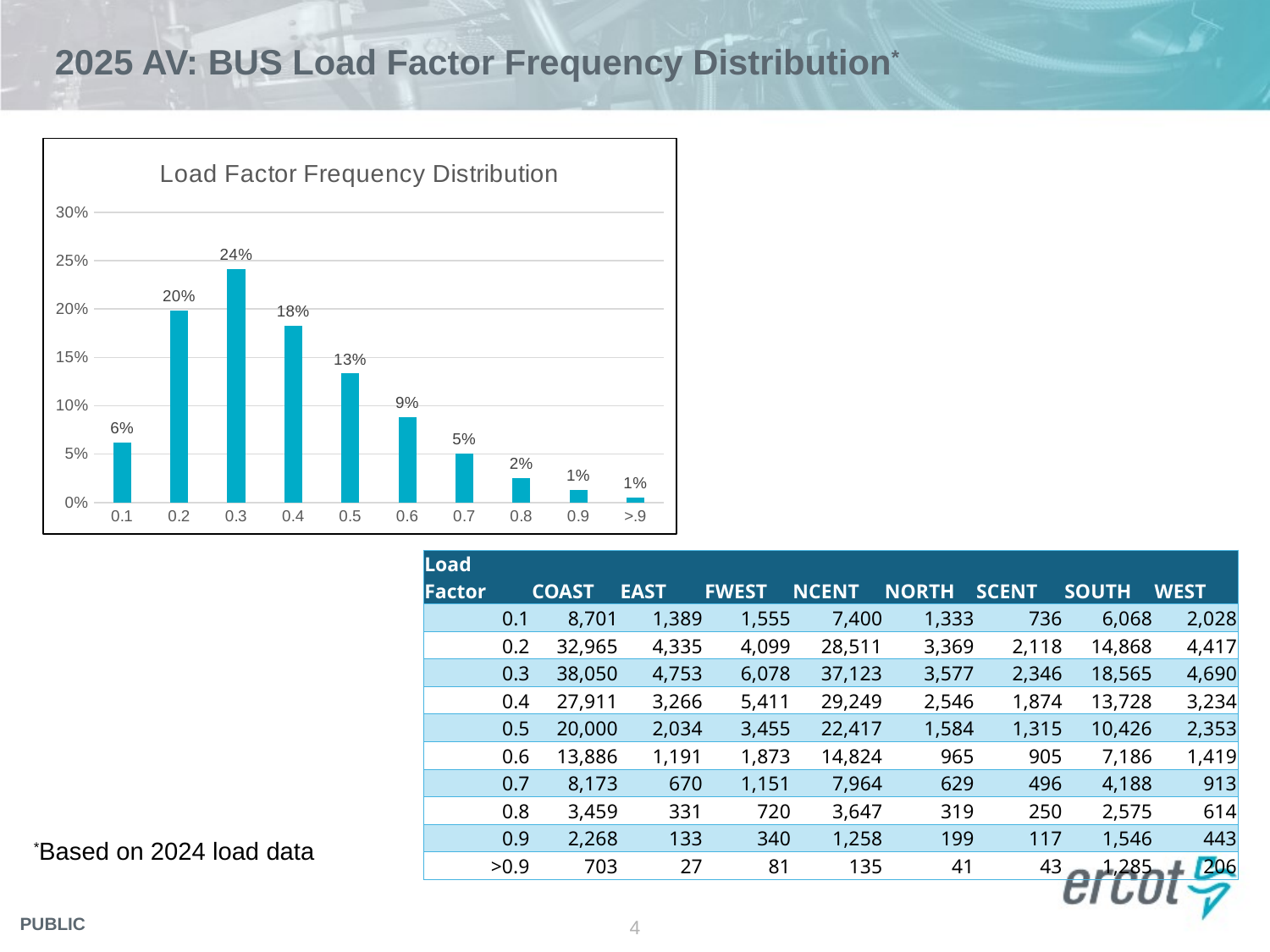
What is the difference between the values for load factor 0.2 and load factor 0.4 in the Load Factor Frequency Distribution chart? 2% Is the value for load factor 0.2 greater or less than 15% in the Load Factor Frequency Distribution chart? greater What is the difference between the values for load factor 0.3 and load factor 0.5 in the Load Factor Frequency Distribution chart? 11% What is the value for load factor 0.6 in the Load Factor Frequency Distribution chart? 9% What kind of chart is the Load Factor Frequency Distribution chart? bar chart Which load factor category has the highest value in the Load Factor Frequency Distribution chart? 0.3 Which is larger in the Load Factor Frequency Distribution chart, the value for load factor 0.4 or the value for load factor 0.5? 0.4 What is the value for load factor 0.3 in the Load Factor Frequency Distribution chart? 24% In the Load Factor Frequency Distribution chart, do the values rise or fall from load factor 0.3 to >.9? fall What is the title of the chart on the slide? Load Factor Frequency Distribution What is the value for load factor 0.1 in the Load Factor Frequency Distribution chart? 6% How many load factor categories are shown on the x axis of the Load Factor Frequency Distribution chart? 10